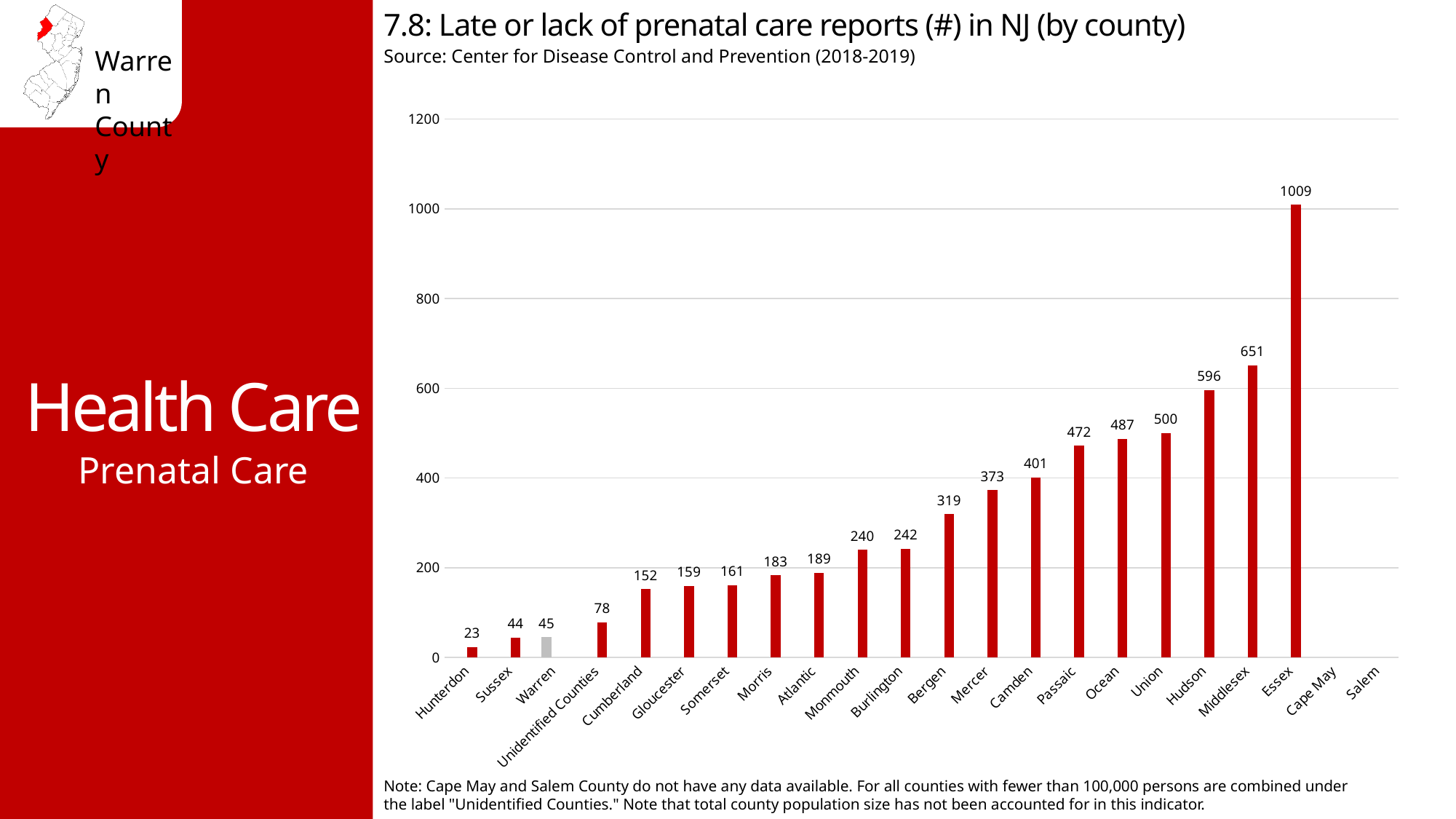
Which county has the highest number of late or lack of prenatal care reports? Essex What kind of chart is shown on the slide? Bar chart Which bar is coloured grey instead of red? Warren How many county labels are shown on the x axis? 22 What is the value for Essex? 1009 Is the value for Union greater or less than 400? greater Which is larger, the value for Bergen or the value for Mercer? Mercer Which county has the lowest number of late or lack of prenatal care reports? Hunterdon Do the values generally rise or fall from left to right along the x axis? Rise What is the value for Warren? 45 What is the difference between the values for Middlesex and Hudson? 55 What is the value for Unidentified Counties? 78